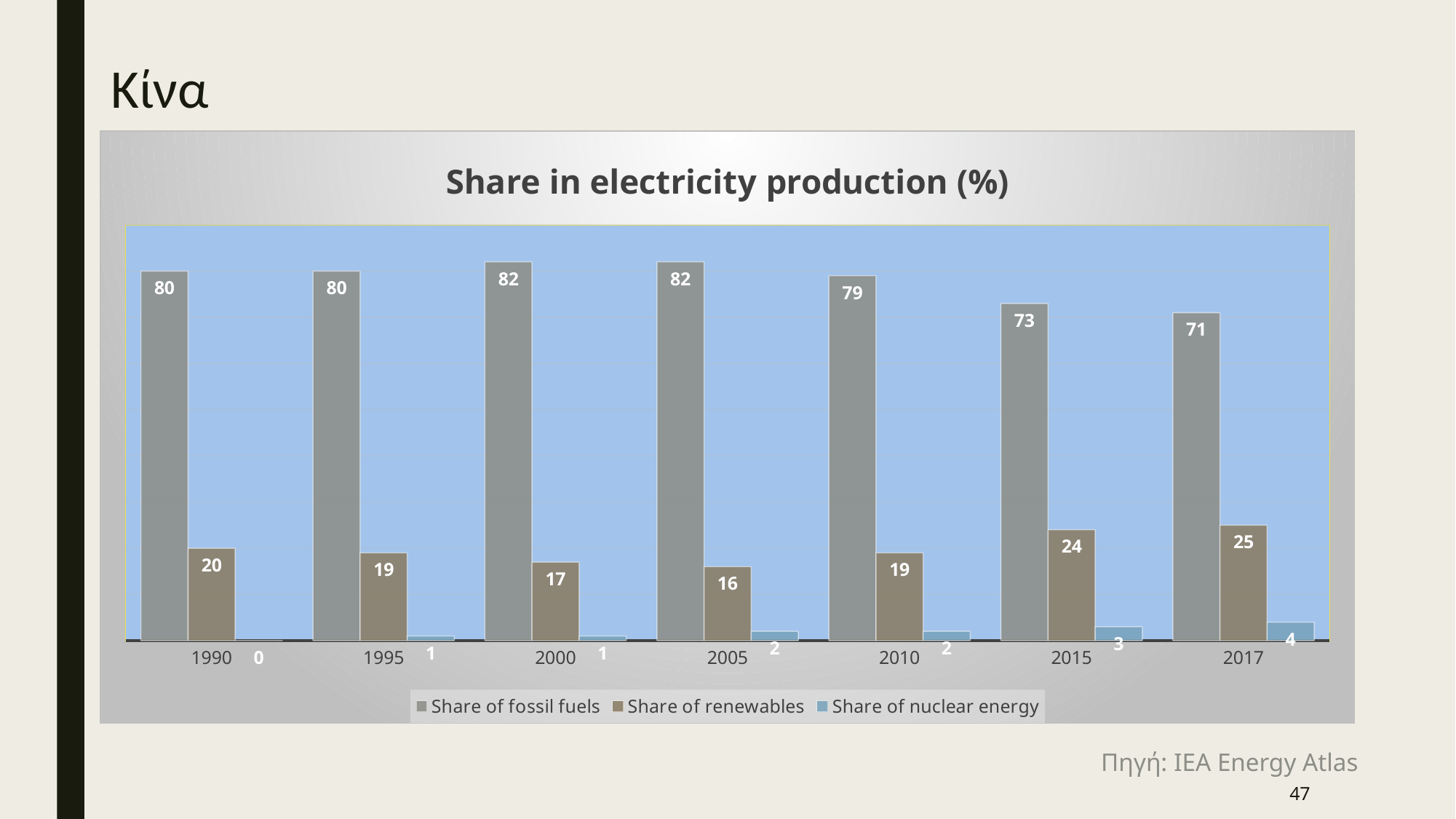
What is the share of fossil fuels in 2017? 71 What is the difference between the share of fossil fuels in 2000 and in 2017? 11 What is the share of nuclear energy in 2015? 3 What kind of chart is shown? Bar chart How many series does the legend list? 3 In which year is the share of renewables highest? 2017 Which is larger, the share of renewables in 1990 or in 2010? 1990 What is the share of renewables in 2005? 16 How many years are shown on the x axis? 7 What is the title of the chart? Share in electricity production (%) In which year is the share of fossil fuels lowest? 2017 Does the share of nuclear energy rise or fall from 1990 to 2017? Rise